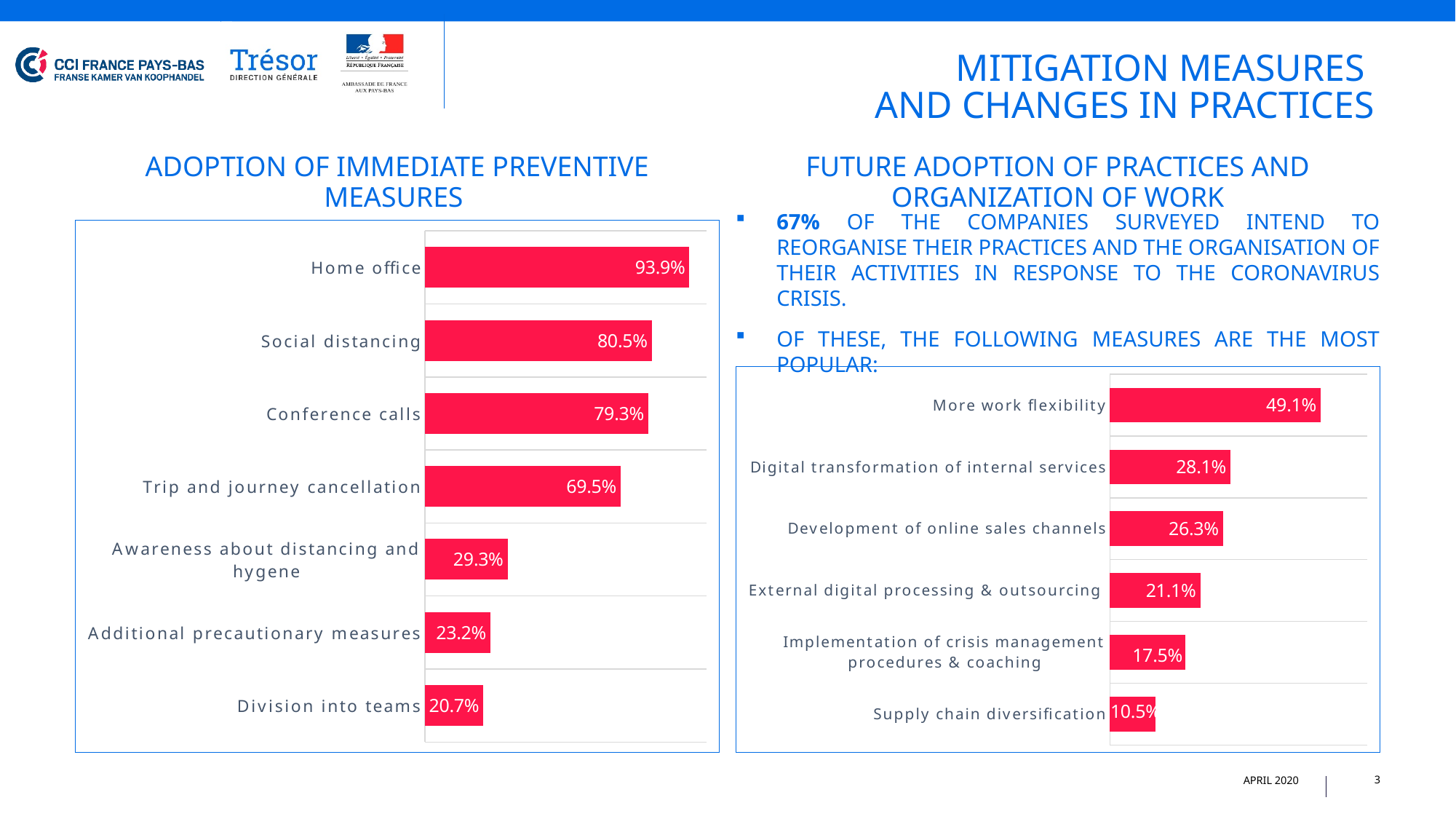
In the 'Future adoption of practices and organization of work' chart, what is the value for More work flexibility? 49.1% In the 'Adoption of immediate preventive measures' chart, how many categories are shown? 7 What type of chart is the 'Future adoption of practices and organization of work' chart? Bar chart In the 'Adoption of immediate preventive measures' chart, which is larger: Awareness about distancing and hygene or Additional precautionary measures? Awareness about distancing and hygene In the 'Future adoption of practices and organization of work' chart, what is the difference between Digital transformation of internal services and Development of online sales channels? 1.8% In the 'Future adoption of practices and organization of work' chart, how many categories are shown? 6 In the 'Adoption of immediate preventive measures' chart, what is the value for Trip and journey cancellation? 69.5% In the 'Adoption of immediate preventive measures' chart, which category has the lowest value? Division into teams In the 'Adoption of immediate preventive measures' chart, what is the value for Home office? 93.9% In the 'Future adoption of practices and organization of work' chart, what is the value for Supply chain diversification? 10.5% In the 'Adoption of immediate preventive measures' chart, what is the difference between Social distancing and Conference calls? 1.2% In the 'Future adoption of practices and organization of work' chart, which category has the highest value? More work flexibility